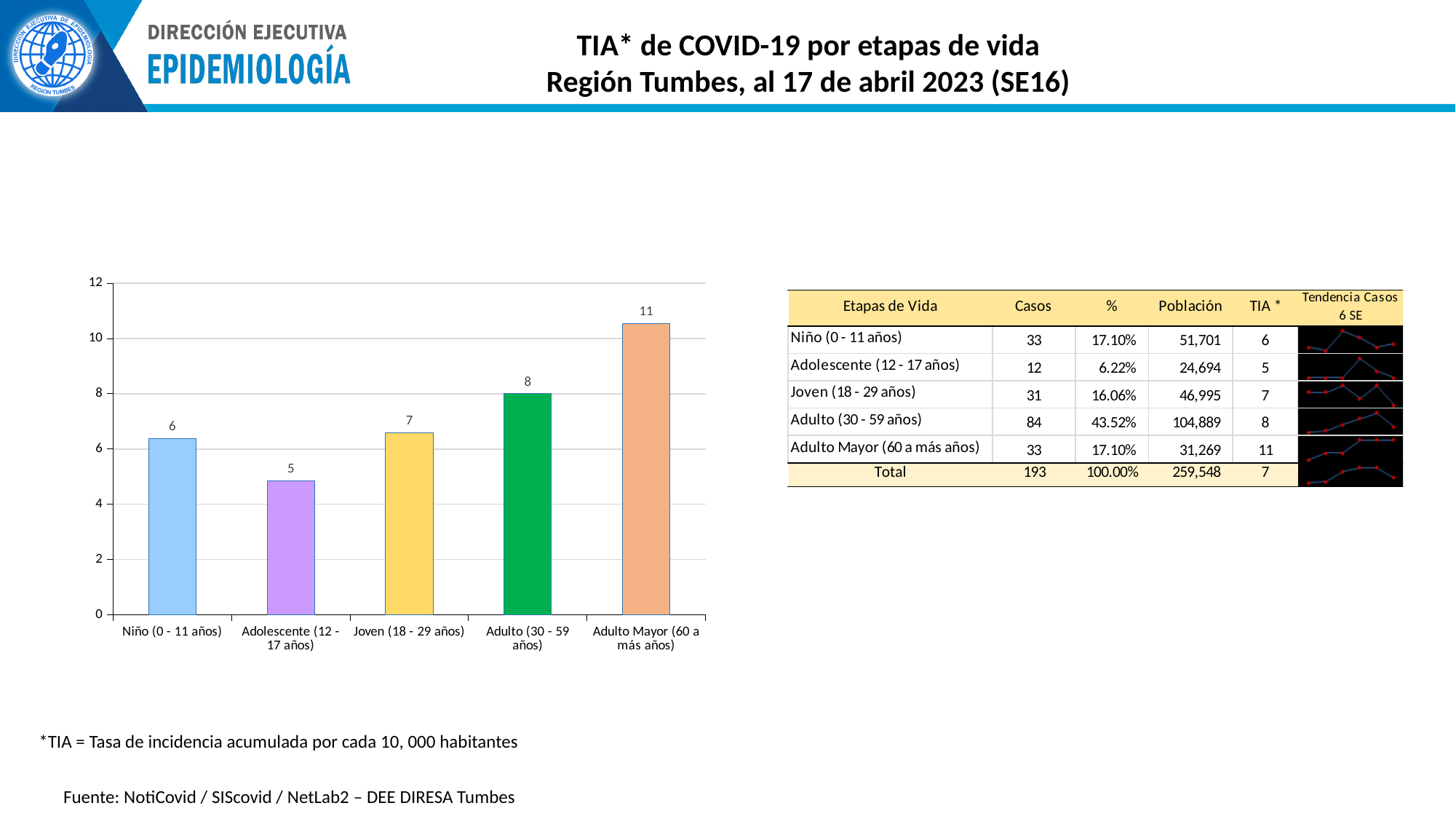
What is the TIA value shown for Adulto Mayor (60 a más años) in the bar chart? 11 Which life stage has the highest TIA in the bar chart? Adulto Mayor (60 a más años) What is the maximum value shown on the vertical axis of the bar chart? 12 What is the TIA value shown for Niño (0 - 11 años) in the bar chart? 6 What is the difference between the TIA labels for Adulto Mayor (60 a más años) and Adolescente (12 - 17 años)? 6 Which has a larger TIA in the bar chart, Adulto (30 - 59 años) or Joven (18 - 29 años)? Adulto (30 - 59 años) What is the TIA value shown for Joven (18 - 29 años) in the bar chart? 7 Which life stage has the lowest TIA in the bar chart? Adolescente (12 - 17 años) What kind of chart is used to show TIA by life stage? Bar chart How many life-stage categories are plotted in the bar chart? 5 Is the bar for Adolescente (12 - 17 años) greater or less than 6 on the axis? less Is the bar for Adulto Mayor (60 a más años) greater or less than 10 on the axis? greater